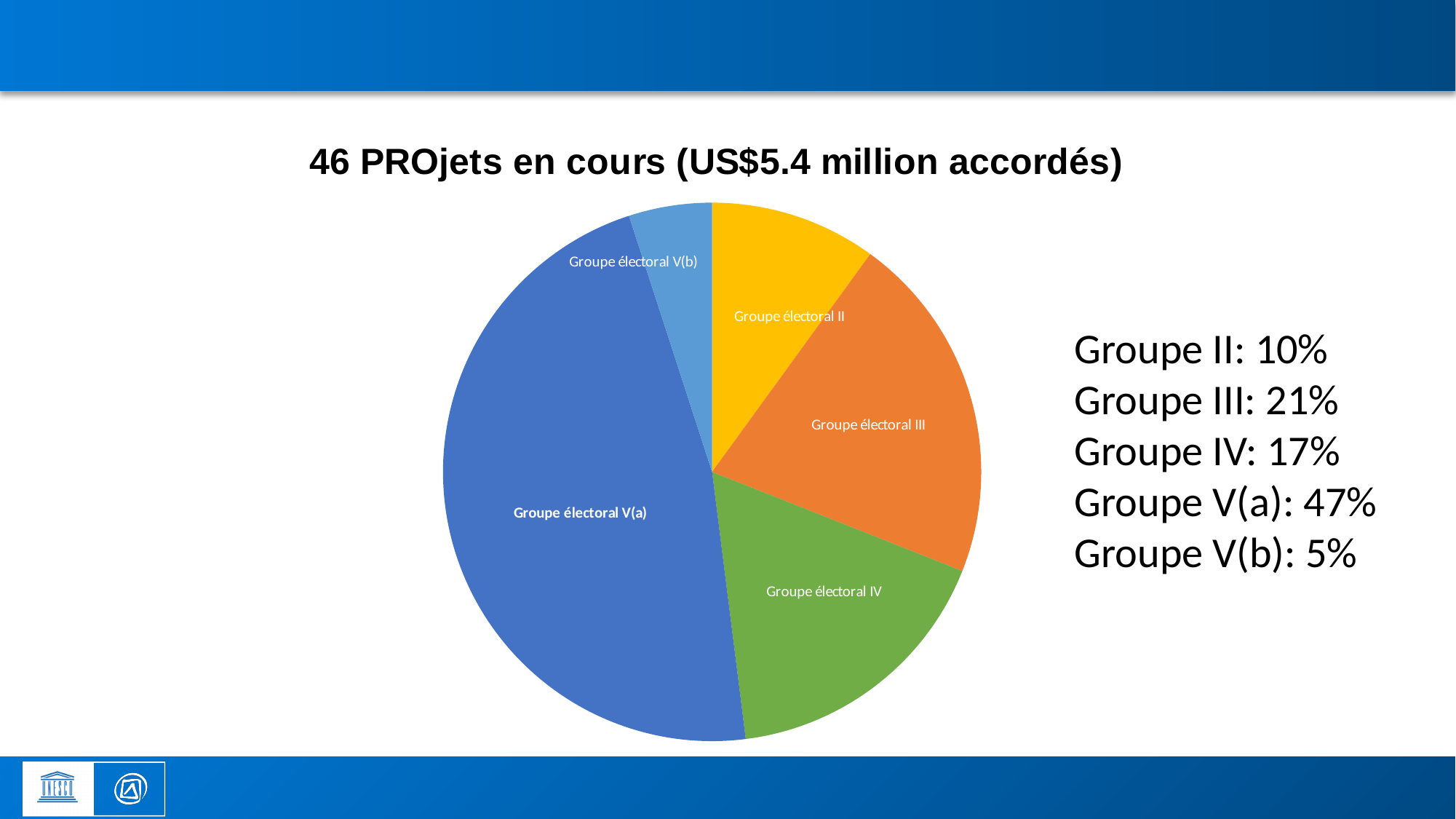
Which is larger, the share for Groupe électoral III or the share for Groupe électoral IV? Groupe électoral III What is the title of the chart? 46 PROjets en cours (US$5.4 million accordés) What share of the pie does Groupe électoral V(a) represent? 47% What share of the pie does Groupe électoral III represent? 21% Which electoral group has the largest slice of the pie? Groupe électoral V(a) What share of the pie does Groupe électoral V(b) represent? 5% What kind of chart is shown on the slide? Pie chart Which electoral group has the smallest slice of the pie? Groupe électoral V(b) What is the difference in percentage points between Groupe électoral III and Groupe électoral IV? 4 What colour is the slice for Groupe électoral IV? Green How many slices does the pie chart have? 5